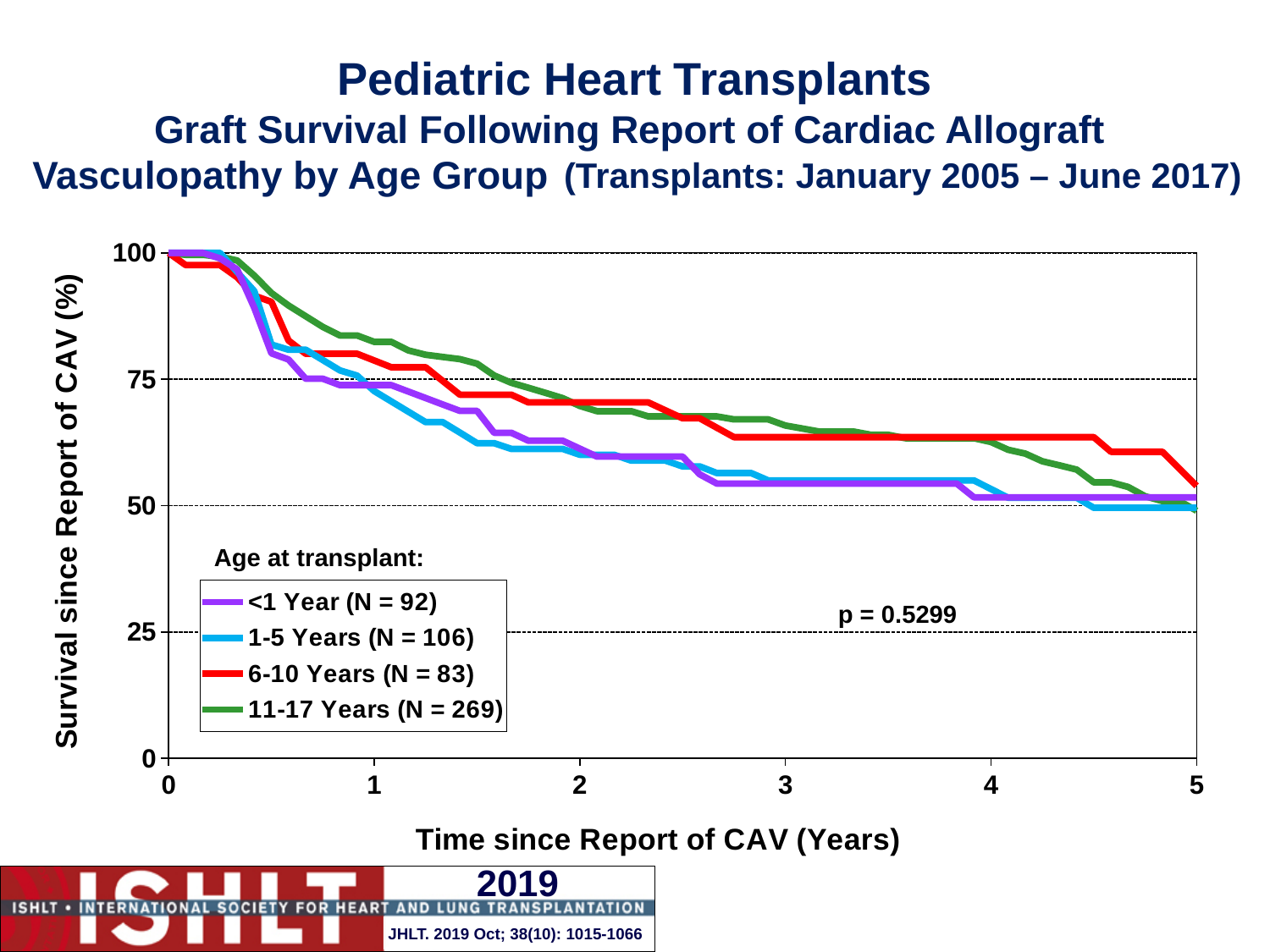
Which age group has the smallest N in the legend? 6-10 Years (N = 83) At 3 years since report of CAV, which group has higher survival: 6-10 Years or <1 Year? 6-10 Years How many age groups (series) does the legend list? 4 Which age group has the largest N in the legend? 11-17 Years (N = 269) What is the N for the 11-17 Years age group? 269 Is the survival value for the 11-17 Years group at 1 year greater or less than 75? greater What is the difference in N between the 11-17 Years group and the <1 Year group? 177 Do the survival curves rise or fall as time since report of CAV increases? Fall Is the survival value for the 1-5 Years group at 2 years greater or less than 75? less What p-value is shown on the chart? p = 0.5299 What is the N for the 1-5 Years age group? 106 What kind of chart is shown on the slide? Line chart